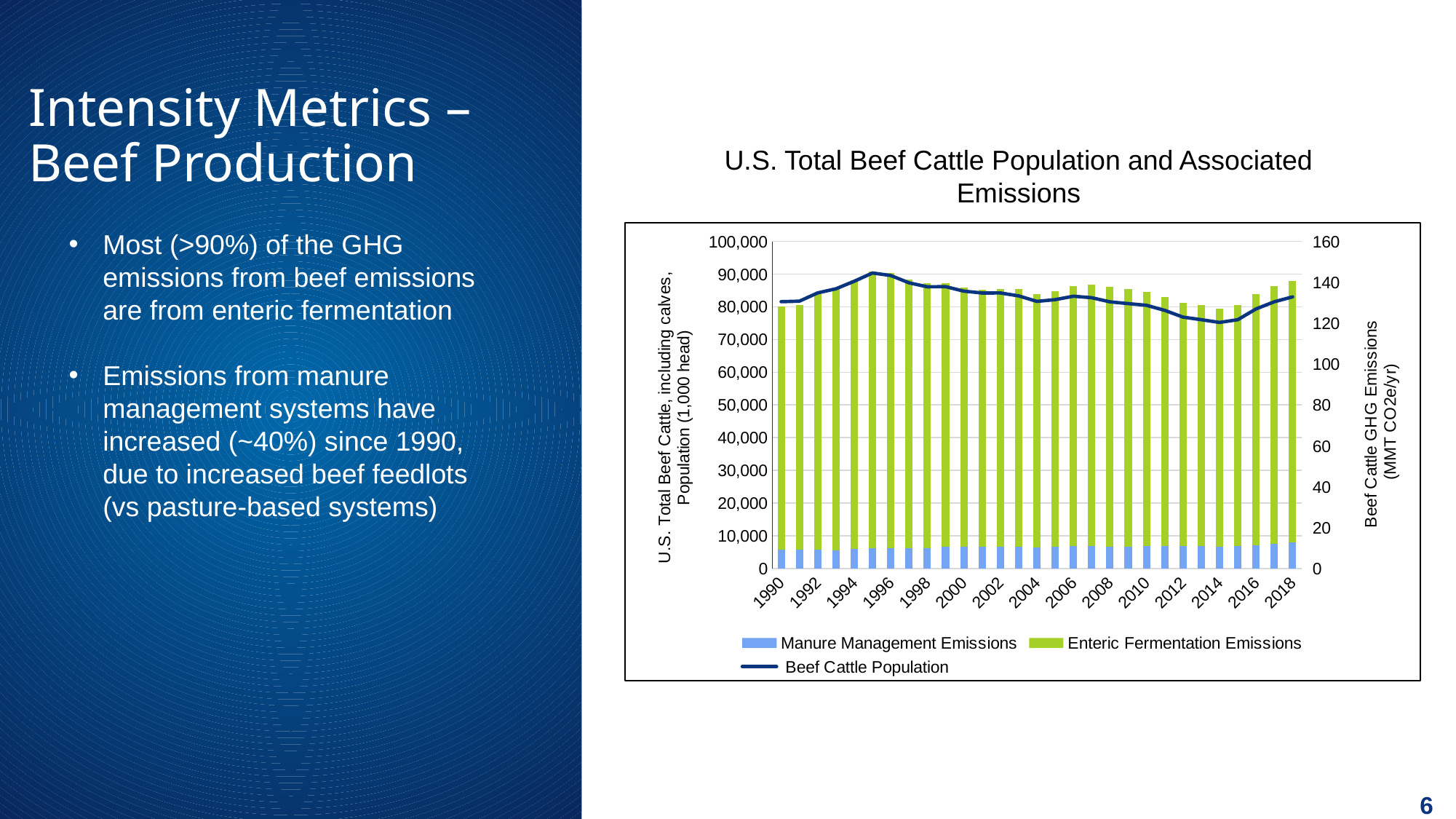
What is the title of the chart? U.S. Total Beef Cattle Population and Associated Emissions Is the Beef Cattle Population value for 2014 greater or less than 80,000? less Is the Beef Cattle Population value for 1996 greater or less than 80,000? greater Which series is shown as a line rather than bars? Beef Cattle Population Is the Beef Cattle Population value for 1996 greater or less than 100,000? less How many years (bars) are plotted along the x axis of the chart? 29 How many series does the chart legend list? 3 Which of the two bar series, Manure Management Emissions or Enteric Fermentation Emissions, is larger in 2018? Enteric Fermentation Emissions Does the Beef Cattle Population line rise or fall between 1996 and 2014? fall Does the Beef Cattle Population line rise or fall between 2014 and 2018? rise What is the maximum value shown on the right-hand axis (Beef Cattle GHG Emissions)? 160 What kind of chart is shown on the slide? Combination of a stacked bar chart and a line chart